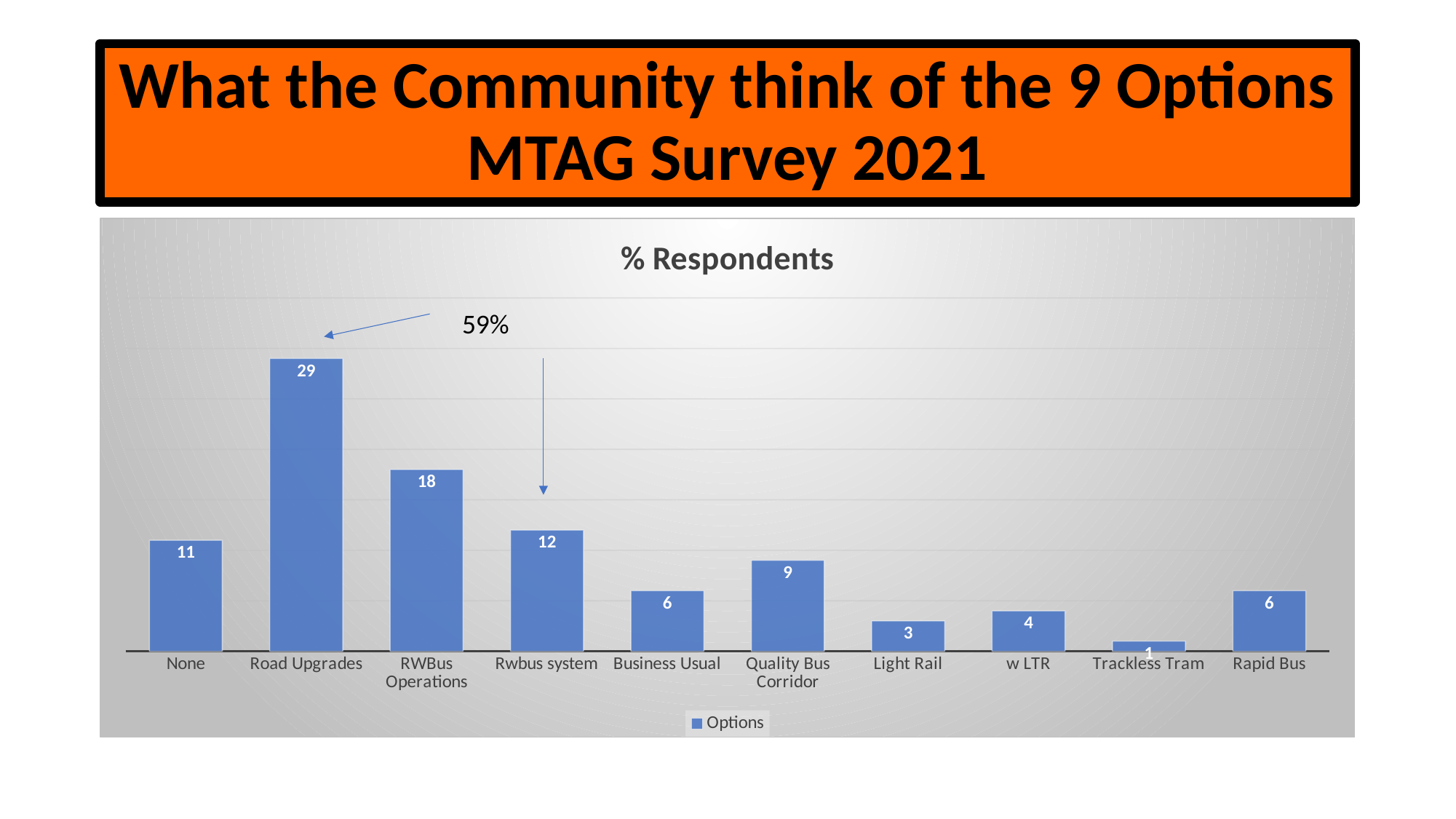
What is the difference between the values for Road Upgrades and RWBus Operations? 11 Which category has the highest value? Road Upgrades How many categories are shown on the x axis? 10 What is the name of the series in the legend? Options What is the value for RWBus Operations? 18 Which is larger, the value for None or the value for Rwbus system? Rwbus system What kind of chart is shown? bar chart What is the title of the chart? % Respondents Which category has the lowest value? Trackless Tram What is the value for Quality Bus Corridor? 9 How many series does the legend list? 1 What is the value for Road Upgrades? 29